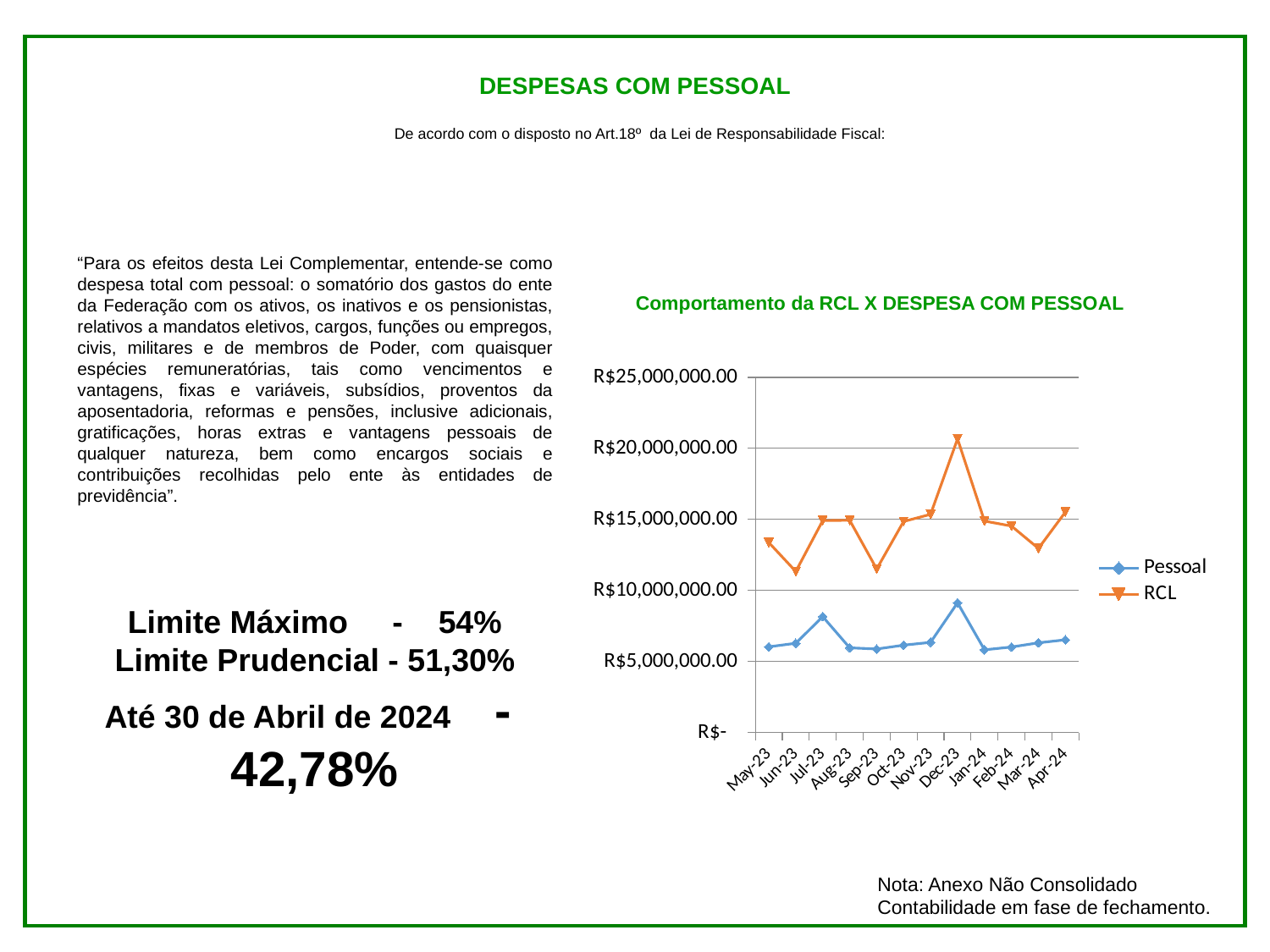
How many months are plotted along the x axis of the chart? 12 What is the title of the chart on the slide? Comportamento da RCL X DESPESA COM PESSOAL Is the Pessoal value for Dec-23 greater or less than R$10,000,000.00? less Is the RCL value for Jun-23 greater or less than R$10,000,000.00? greater In which month does the Pessoal series reach its highest value? Dec-23 What are the two series named in the chart legend? Pessoal and RCL Which series has the larger value in Apr-24, Pessoal or RCL? RCL In which month does the RCL series reach its highest value? Dec-23 Is the Pessoal value for May-23 greater or less than R$5,000,000.00? greater How many series does the legend of the chart list? 2 What kind of chart is shown under the title "Comportamento da RCL X DESPESA COM PESSOAL"? line chart